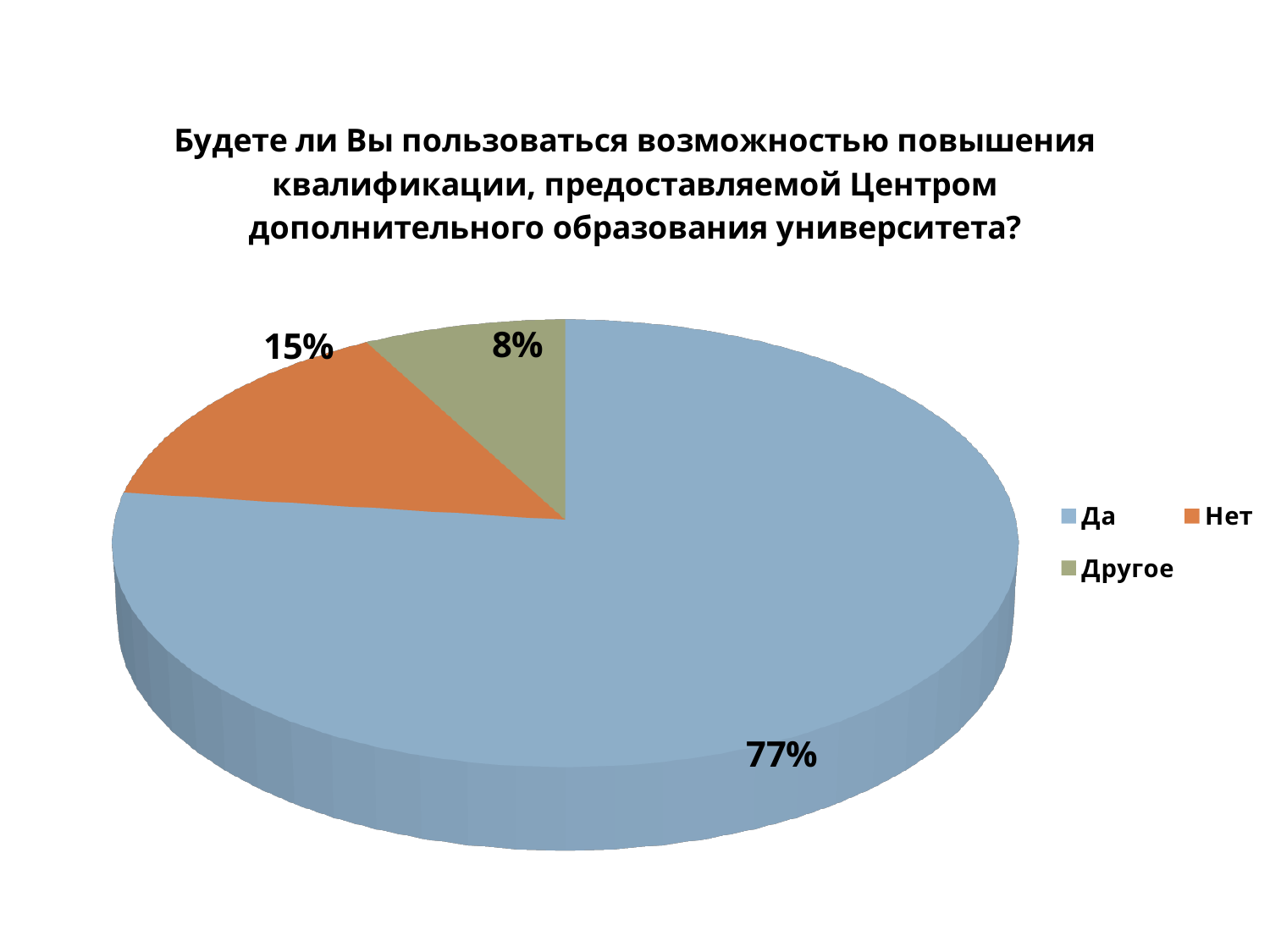
What share of the pie does the "Другое" slice represent? 8% Which category has the largest slice of the pie? Да What share of the pie does the "Да" slice represent? 77% What share of the pie does the "Нет" slice represent? 15% How many categories are shown in the pie chart? 3 What is the difference in percentage points between the "Нет" and "Другое" slices? 7 Which category does the blue slice represent? Да What is the difference in percentage points between the "Да" and "Нет" slices? 62 What colour is the "Нет" slice in the pie chart? Orange Which category has the smallest slice of the pie? Другое What kind of chart is shown on the slide? Pie chart Which slice is larger, "Нет" or "Другое"? Нет